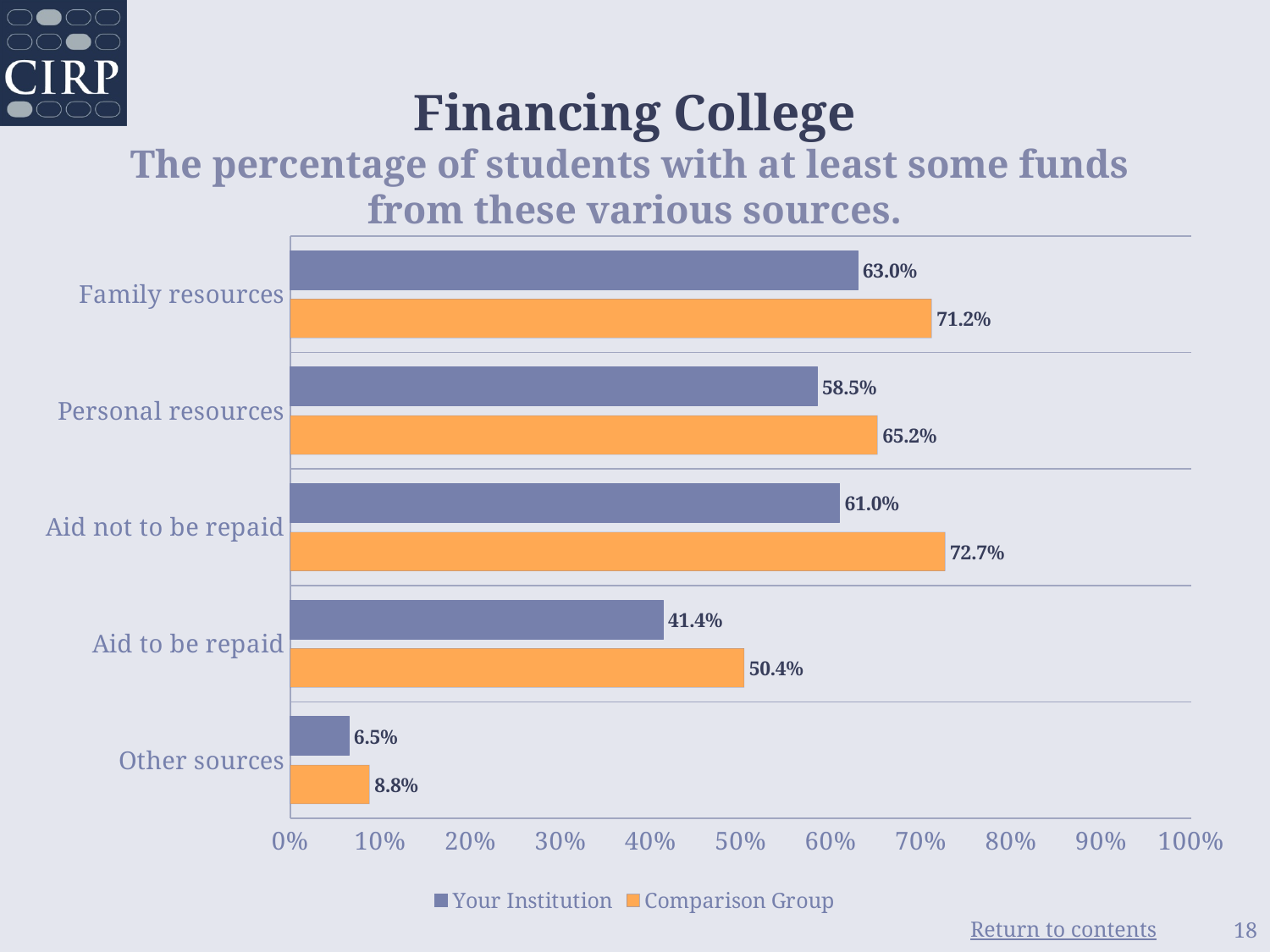
What colour are the bars for the Comparison Group? Orange How many series does the legend list? 2 For Aid not to be repaid, which series has the larger value, Your Institution or Comparison Group? Comparison Group What is the value for Family resources for Your Institution? 63.0% What is the value for Other sources for Your Institution? 6.5% Is the value for Aid to be repaid for Your Institution greater or less than 50%? less What is the value for Aid to be repaid for the Comparison Group? 50.4% How many categories are shown on the chart? 5 What is the difference between the Comparison Group and Your Institution values for Personal resources? 6.7% What kind of chart is shown on the slide? Bar chart Which category has the lowest value for Your Institution? Other sources Which category has the highest value for the Comparison Group? Aid not to be repaid